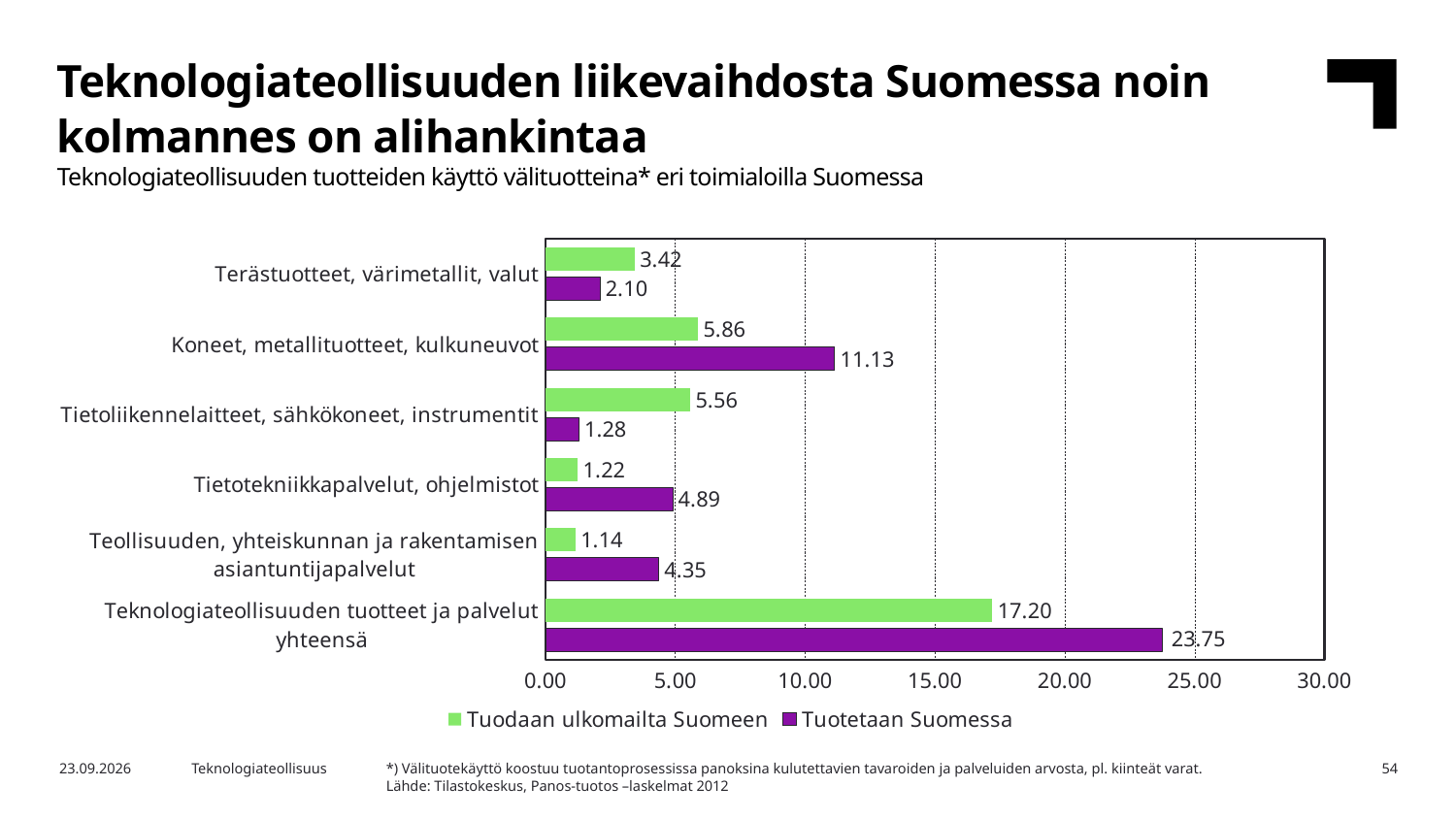
What is the difference between the "Tuotetaan Suomessa" and "Tuodaan ulkomailta Suomeen" values for Koneet, metallituotteet, kulkuneuvot? 5.27 How many categories are shown on the chart? 6 What type of chart is shown on the slide? Bar chart Excluding the total row (yhteensä), which category has the highest "Tuotetaan Suomessa" value? Koneet, metallituotteet, kulkuneuvot Is the "Tuotetaan Suomessa" value for Teknologiateollisuuden tuotteet ja palvelut yhteensä greater or less than 20.00? greater How many series does the legend list? 2 For Tietotekniikkapalvelut, ohjelmistot, which is larger: "Tuodaan ulkomailta Suomeen" or "Tuotetaan Suomessa"? Tuotetaan Suomessa What is the value of "Tuotetaan Suomessa" for Teknologiateollisuuden tuotteet ja palvelut yhteensä? 23.75 Which category has the lowest "Tuodaan ulkomailta Suomeen" value? Teollisuuden, yhteiskunnan ja rakentamisen asiantuntijapalvelut What is the value of "Tuodaan ulkomailta Suomeen" for Tietoliikennelaitteet, sähkökoneet, instrumentit? 5.56 What is the value of "Tuotetaan Suomessa" for Koneet, metallituotteet, kulkuneuvot? 11.13 What is the value of "Tuodaan ulkomailta Suomeen" for Terästuotteet, värimetallit, valut? 3.42